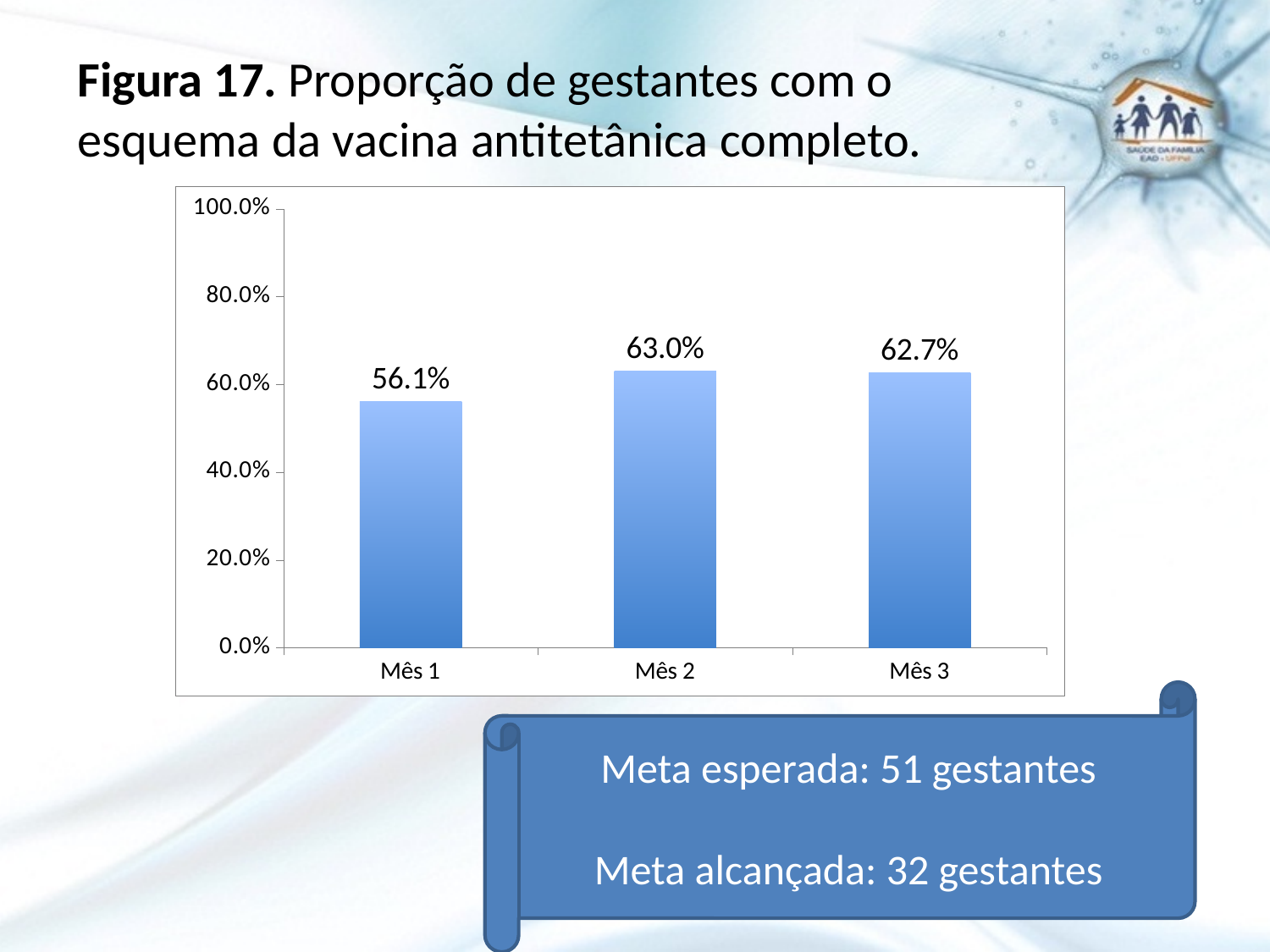
What is the difference between the values for Mês 2 and Mês 3? 0.3% Which month has the highest value? Mês 2 Is the value for Mês 1 greater or less than 60.0%? less What is the value for Mês 2? 63.0% What kind of chart is shown on the slide? bar chart What is the value for Mês 1? 56.1% What is the figure number given in the slide title? Figura 17 Which is larger, the value for Mês 1 or the value for Mês 3? Mês 3 Which month has the lowest value? Mês 1 What is the value for Mês 3? 62.7% What is the difference between the values for Mês 2 and Mês 1? 6.9% How many months are shown on the x axis? 3